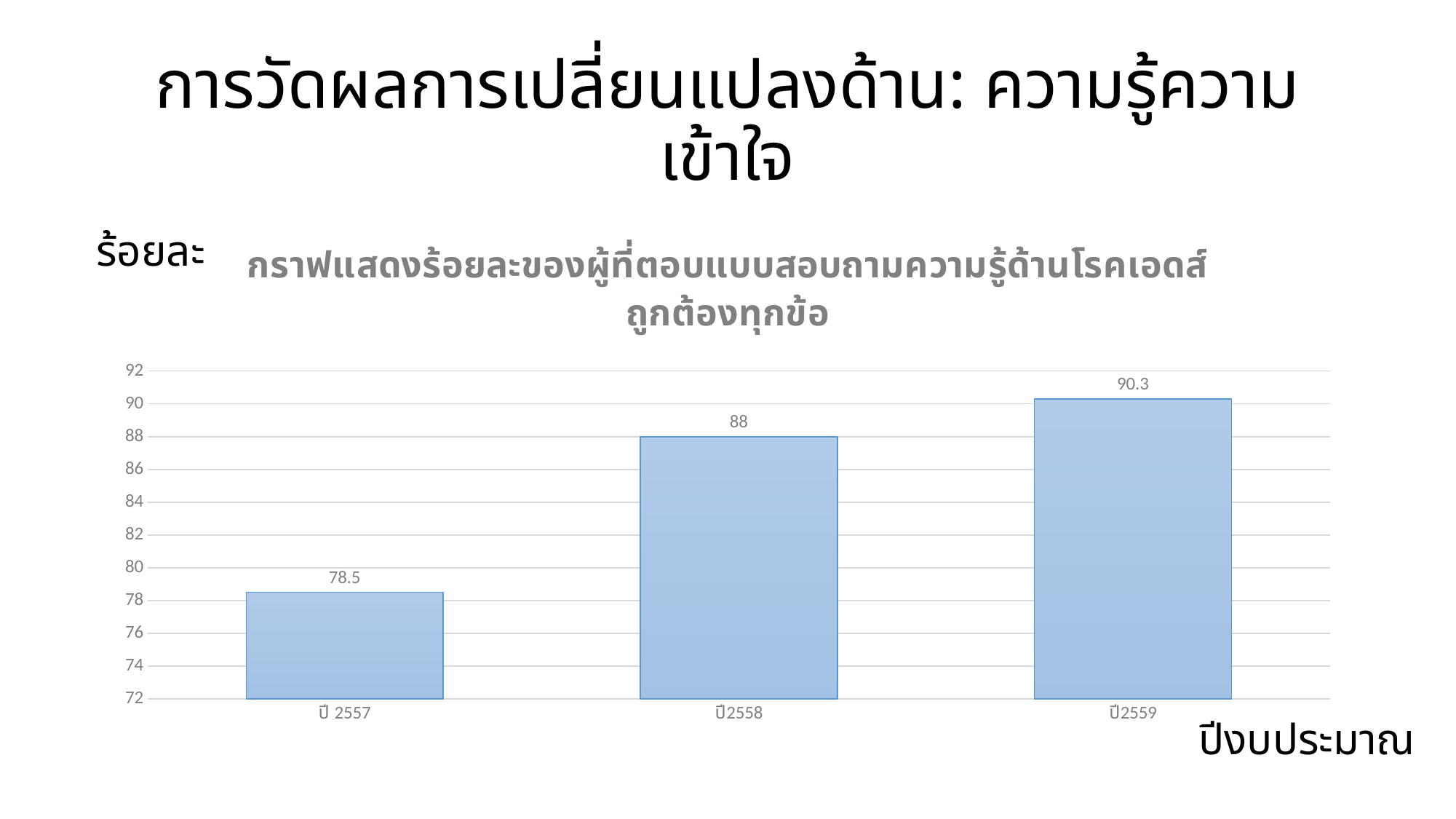
Which year has the lowest value? ปี 2557 What is the value for ปี2558? 88 What is the difference between the values for ปี2558 and ปี 2557? 9.5 How many bars are shown in the chart? 3 Do the values rise or fall from ปี 2557 to ปี2559? rise Is the value for ปี 2557 greater or less than 80? less What kind of chart is shown on the slide? bar chart What is the value for ปี2559? 90.3 Which is larger, the value for ปี2558 or the value for ปี 2557? ปี2558 What is the value for ปี 2557? 78.5 Which year has the highest value? ปี2559 What is the difference between the values for ปี2559 and ปี 2557? 11.8